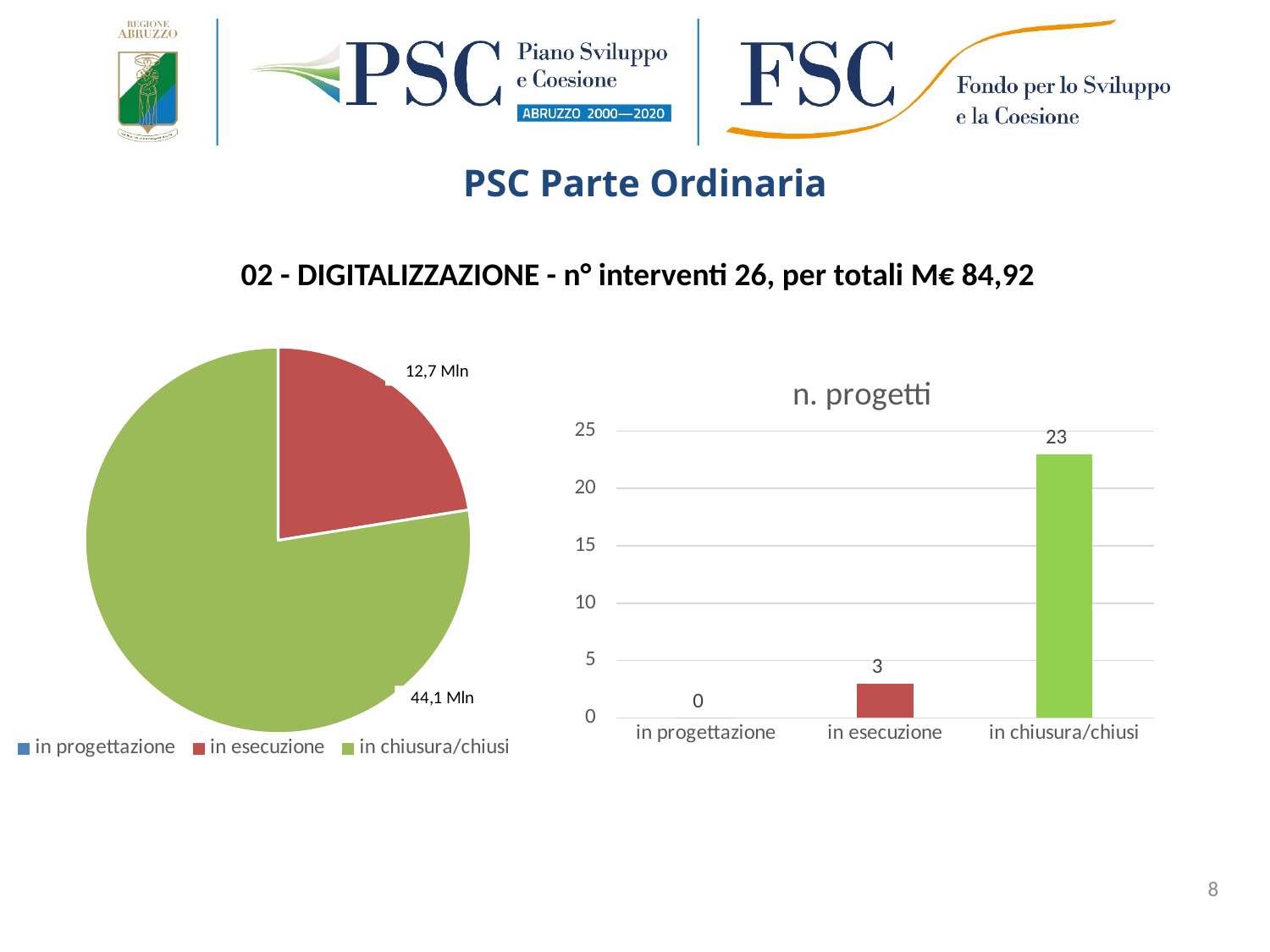
In the bar chart titled "n. progetti", what is the difference between the values for "in chiusura/chiusi" and "in esecuzione"? 20 In the pie chart on the left of the slide, what value is labelled on the green slice (in chiusura/chiusi)? 44,1 Mln What kind of chart is the chart on the right of the slide, titled "n. progetti"? bar chart In the bar chart titled "n. progetti", what is the value for "in esecuzione"? 3 In the bar chart titled "n. progetti", how many categories are shown on the x axis? 3 In the bar chart titled "n. progetti", which category has the highest value? in chiusura/chiusi In the bar chart titled "n. progetti", what is the value for "in chiusura/chiusi"? 23 In the pie chart on the left of the slide, what value is labelled on the red slice (in esecuzione)? 12,7 Mln How many entries does the legend of the pie chart on the left of the slide list? 3 In the pie chart on the left of the slide, which is larger: the value for "in esecuzione" or the value for "in chiusura/chiusi"? in chiusura/chiusi In the bar chart titled "n. progetti", what is the value for "in progettazione"? 0 In the bar chart titled "n. progetti", which category has the lowest value? in progettazione